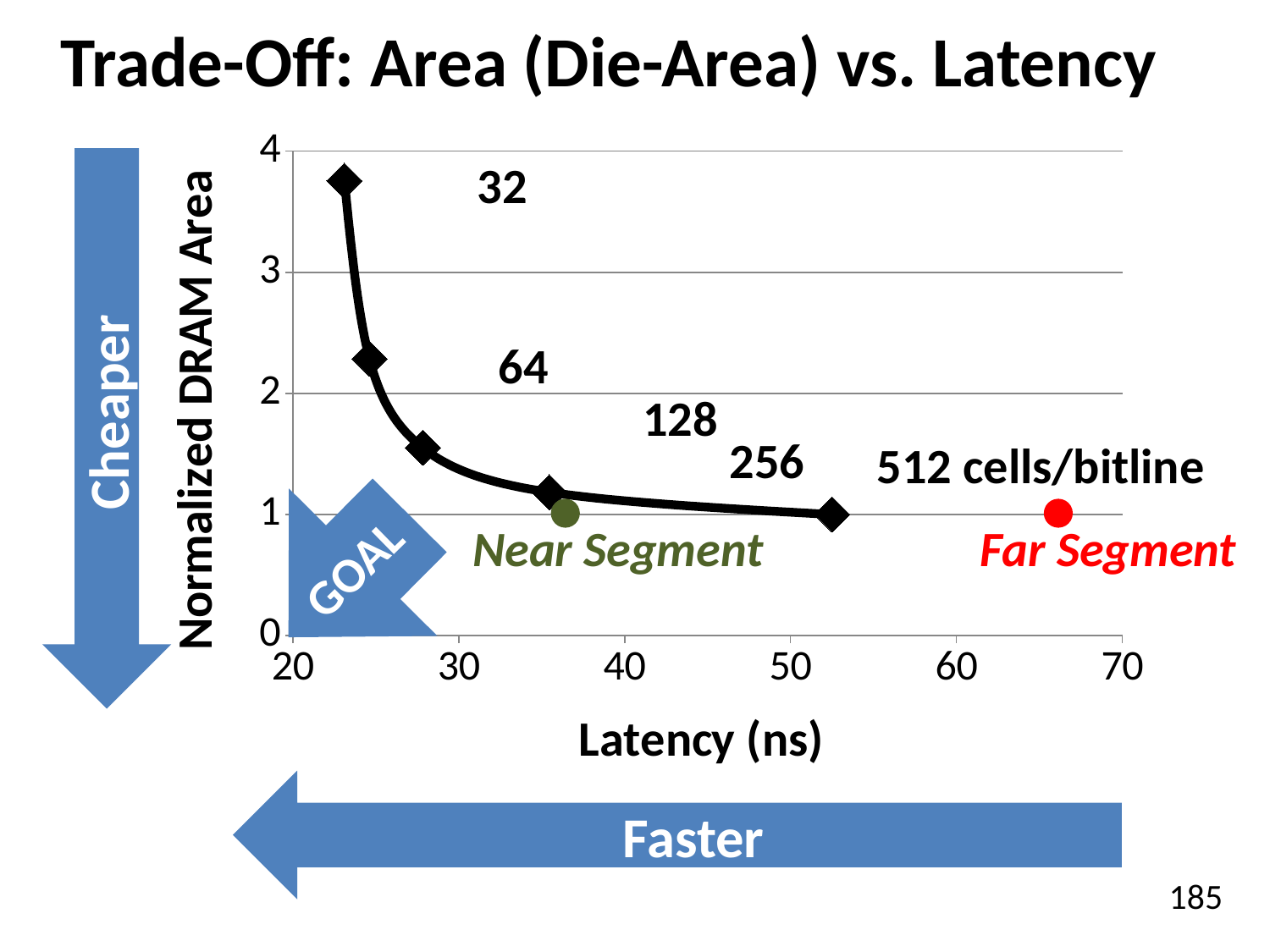
Is the latency of the Far Segment point greater or less than 60 ns? greater Which cells/bitline configuration has the highest normalized DRAM area? 32 What kind of chart is shown on the slide? line chart Which has a higher normalized DRAM area, the 64 cells/bitline point or the 256 cells/bitline point? 64 As latency increases along the x axis, does the normalized DRAM area rise or fall? fall Which cells/bitline configuration has the lowest normalized DRAM area? 512 How many black diamond data points are plotted on the curve? 5 Is the latency for the 512 cells/bitline point greater or less than 50 ns? greater What is the title of the y axis? Normalized DRAM Area What is the title of the x axis? Latency (ns) Is the normalized DRAM area for the 64 cells/bitline point greater or less than 2? greater